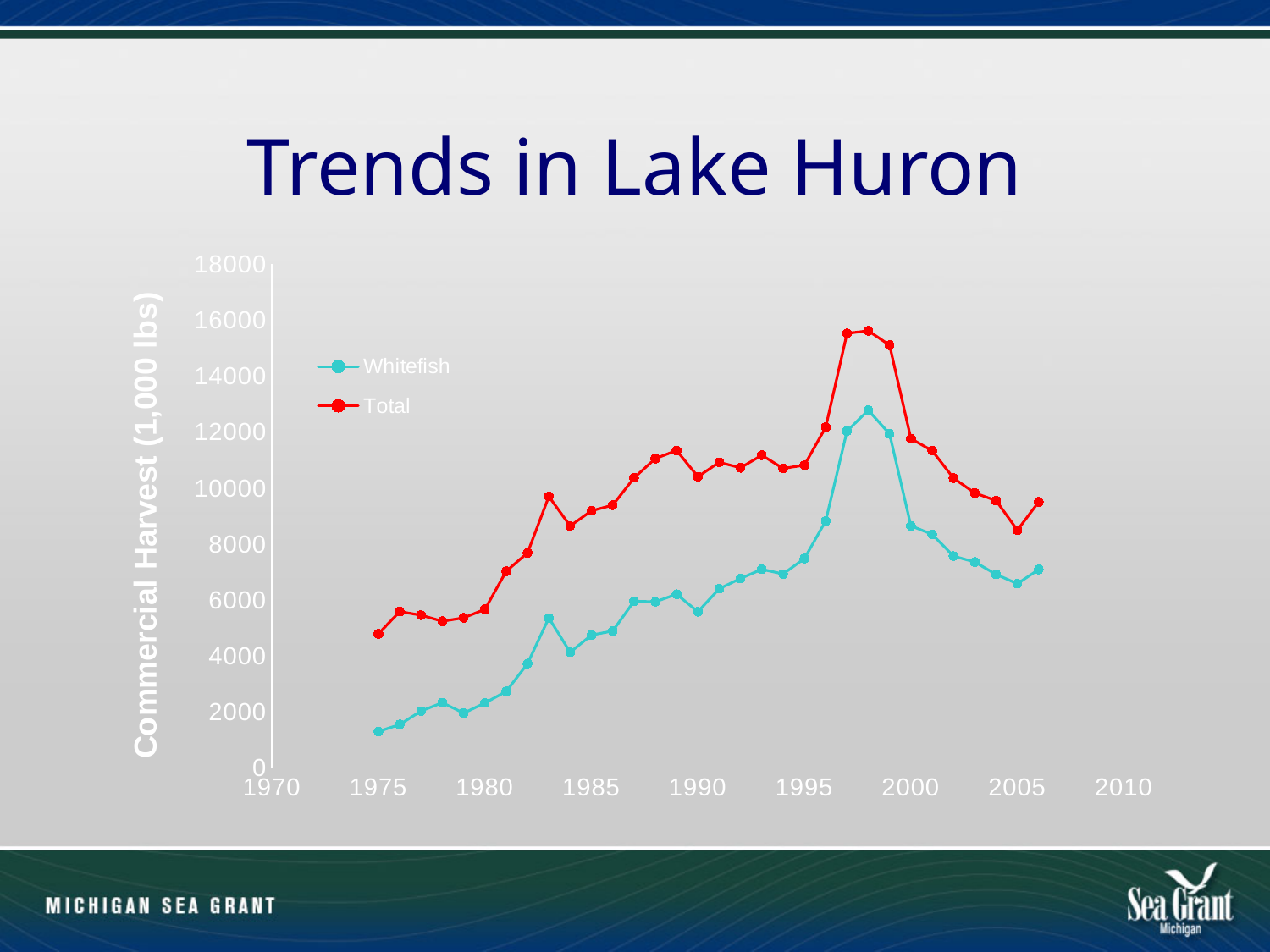
What kind of chart is shown on the slide? line chart What is the label of the y axis? Commercial Harvest (1,000 lbs) In which year does the Total series reach its highest value? 1998 What colour is the Total line? red Is the Total value for 1998 greater or less than 14000? greater How many series does the legend list? 2 Which series has the larger value in 1998, Whitefish or Total? Total Does the Whitefish series generally rise or fall between 1998 and 2005? fall Is the Whitefish value for 1975 greater or less than 2000? less In which year does the Whitefish series reach its lowest value? 1975 Is the Whitefish value for 2000 greater or less than 8000? greater